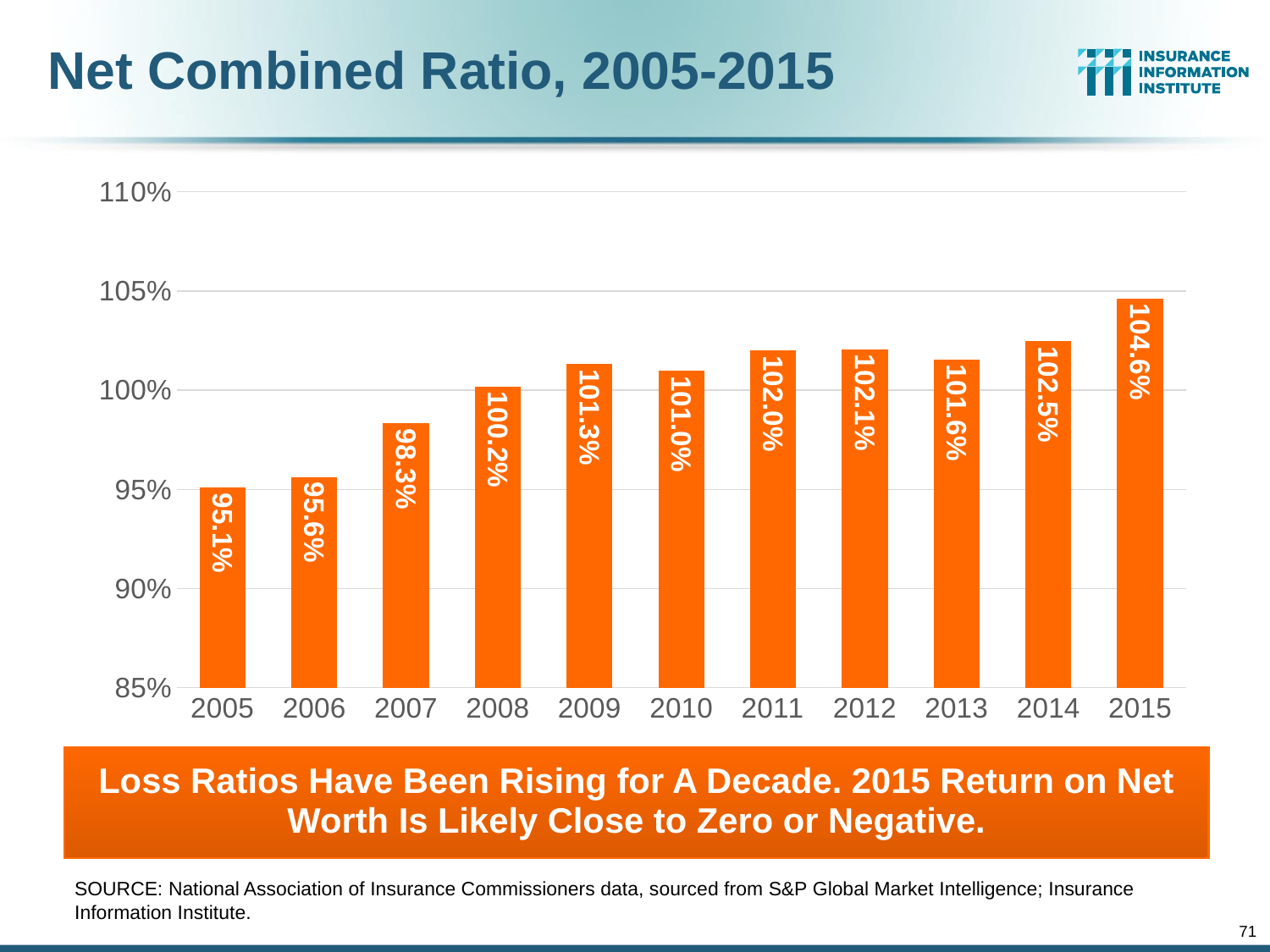
Is the net combined ratio for 2007 greater or less than 100%? less Which year has the lowest net combined ratio? 2005 Which year has a higher net combined ratio, 2012 or 2013? 2012 Do the net combined ratio values generally rise or fall from 2005 to 2015? Rise What kind of chart is shown on the slide? Bar chart What is the net combined ratio for 2008? 100.2% Which year has the highest net combined ratio? 2015 What is the title of the chart? Net Combined Ratio, 2005-2015 What is the difference between the net combined ratio in 2015 and in 2005? 9.5 percentage points What is the net combined ratio for 2005? 95.1% How many years are shown on the chart? 11 What is the net combined ratio for 2015? 104.6%